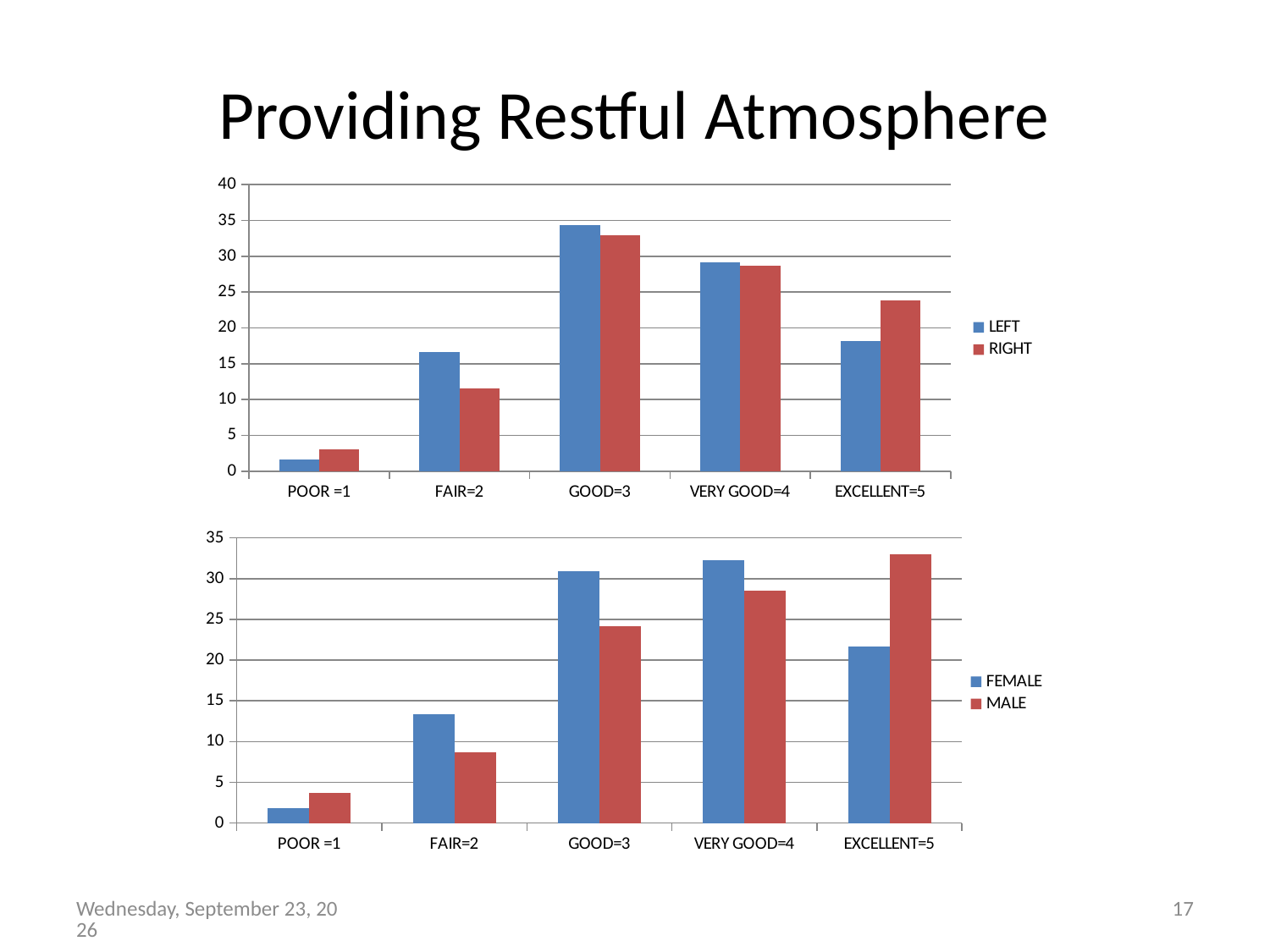
In the top chart, which category has the lowest RIGHT value? POOR =1 How many series does the legend of the top chart list? 2 In the bottom chart, which category has the highest MALE value? EXCELLENT=5 What are the two series named in the legend of the bottom chart? FEMALE and MALE In the bottom chart, for FAIR=2, which is larger, FEMALE or MALE? FEMALE What kind of chart is the top chart on the slide? bar chart How many categories are shown on the x axis of the bottom chart? 5 In the top chart, which category has the highest LEFT value? GOOD=3 In the top chart, is the LEFT value for FAIR=2 greater or less than 15? greater In the bottom chart, which category has the lowest FEMALE value? POOR =1 In the top chart, for EXCELLENT=5, which is larger, LEFT or RIGHT? RIGHT